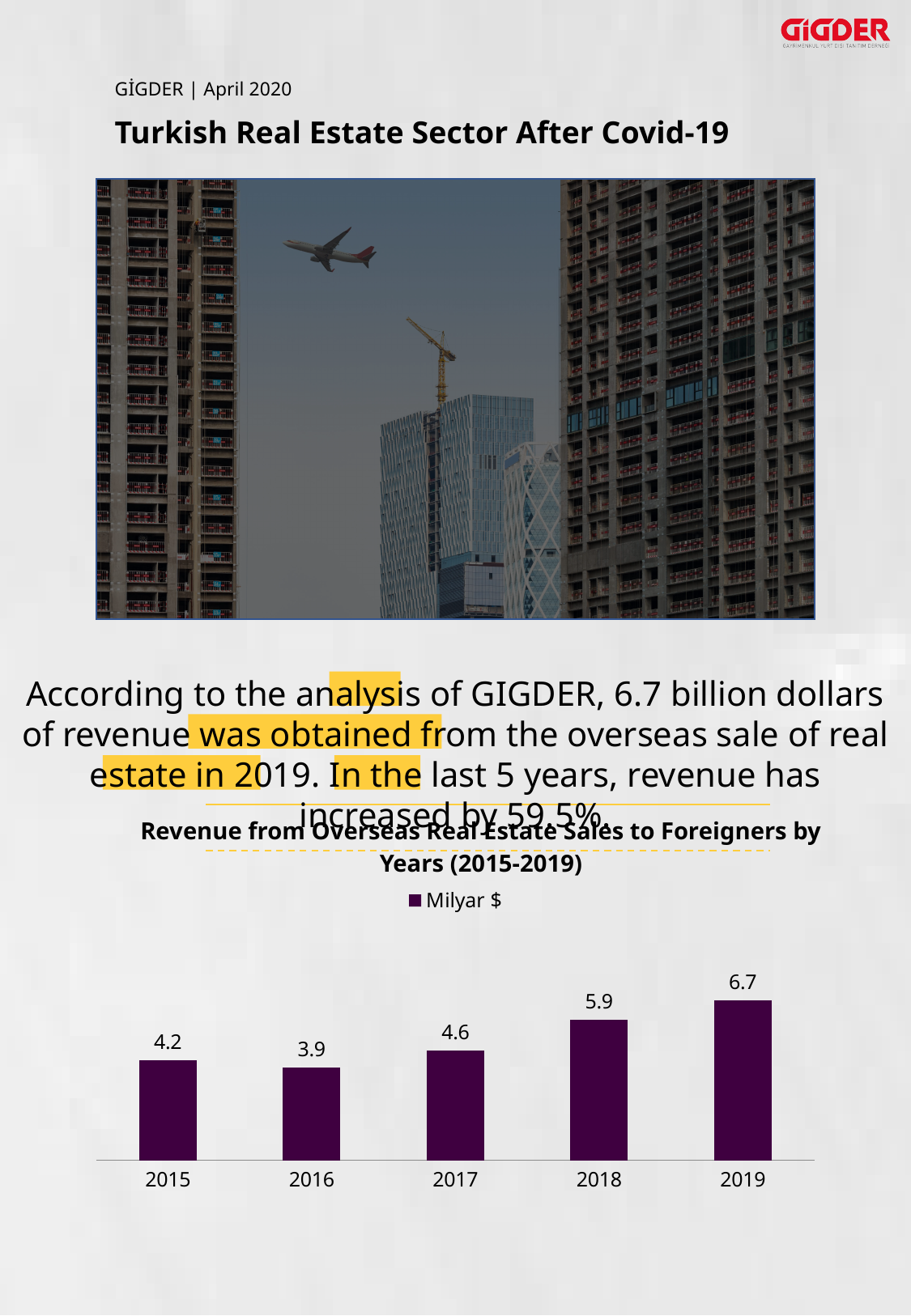
How many years are shown on the x axis of the chart? 5 How many series does the chart legend list? 1 What is the value for 2016 in the chart? 3.9 What kind of chart is shown on the slide? bar chart What is the difference between the values for 2019 and 2015? 2.5 What is the value for 2017 in the chart? 4.6 What is the difference between the values for 2018 and 2017? 1.3 Which year has the lowest value in the chart? 2016 Which is larger, the value for 2015 or the value for 2016? 2015 What is the value for 2019 in the chart? 6.7 Which year has the highest value in the chart? 2019 What is the name of the series shown in the chart legend? Milyar $